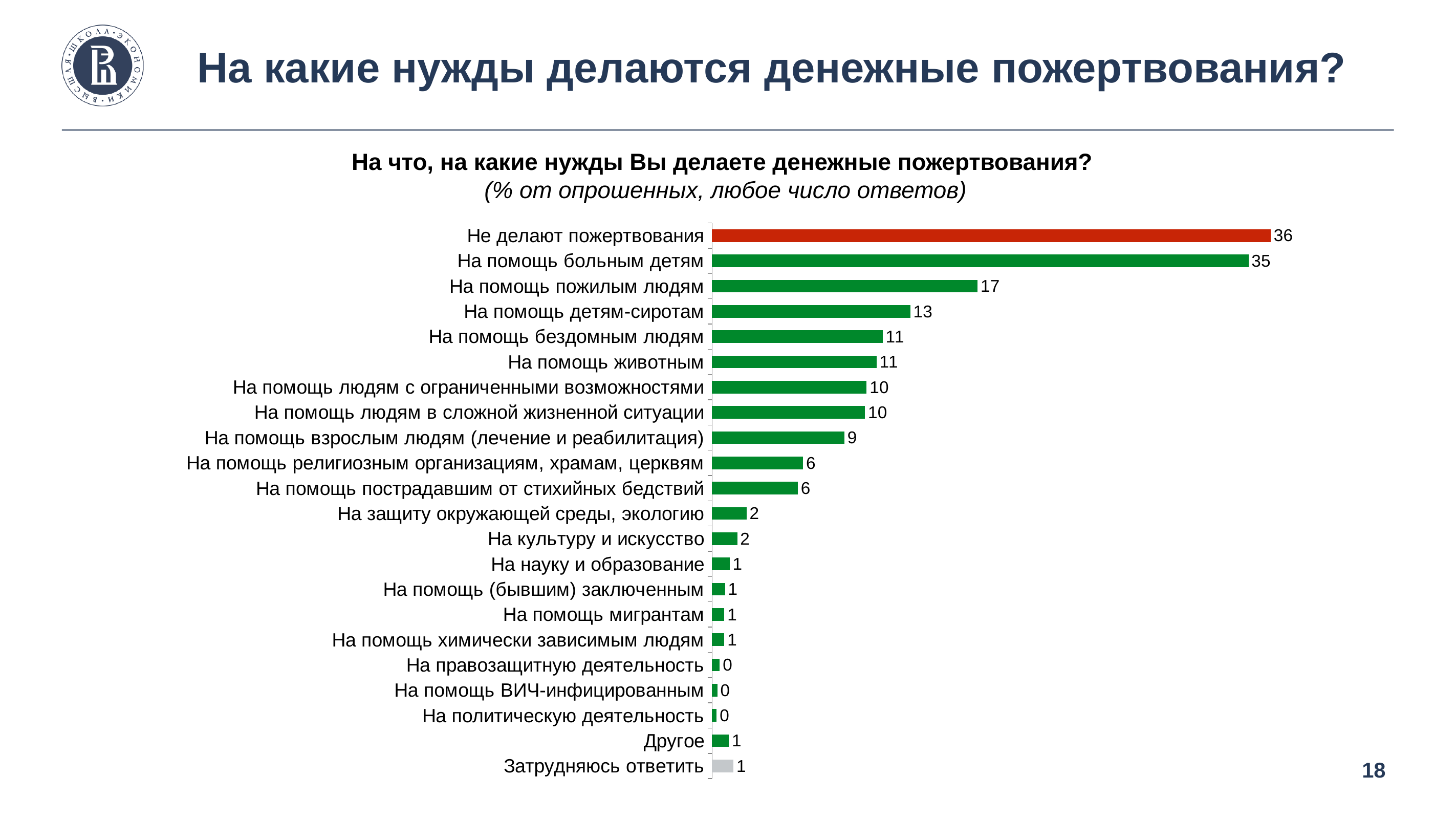
What is the value for "На помощь больным детям"? 35 How many categories are shown in the chart? 22 Which category has the highest value? Не делают пожертвования What is the difference between the values for "Не делают пожертвования" and "На помощь больным детям"? 1 Which is larger, the value for "На помощь животным" or the value for "На помощь взрослым людям (лечение и реабилитация)"? На помощь животным Which bar is coloured red? Не делают пожертвования What is the value for "На помощь детям-сиротам"? 13 What is the difference between the values for "На помощь пожилым людям" and "На помощь детям-сиротам"? 4 What is the value for "На помощь религиозным организациям, храмам, церквям"? 6 What is the value for "На защиту окружающей среды, экологию"? 2 What is the value for "На помощь пожилым людям"? 17 What kind of chart is shown on the slide? Bar chart